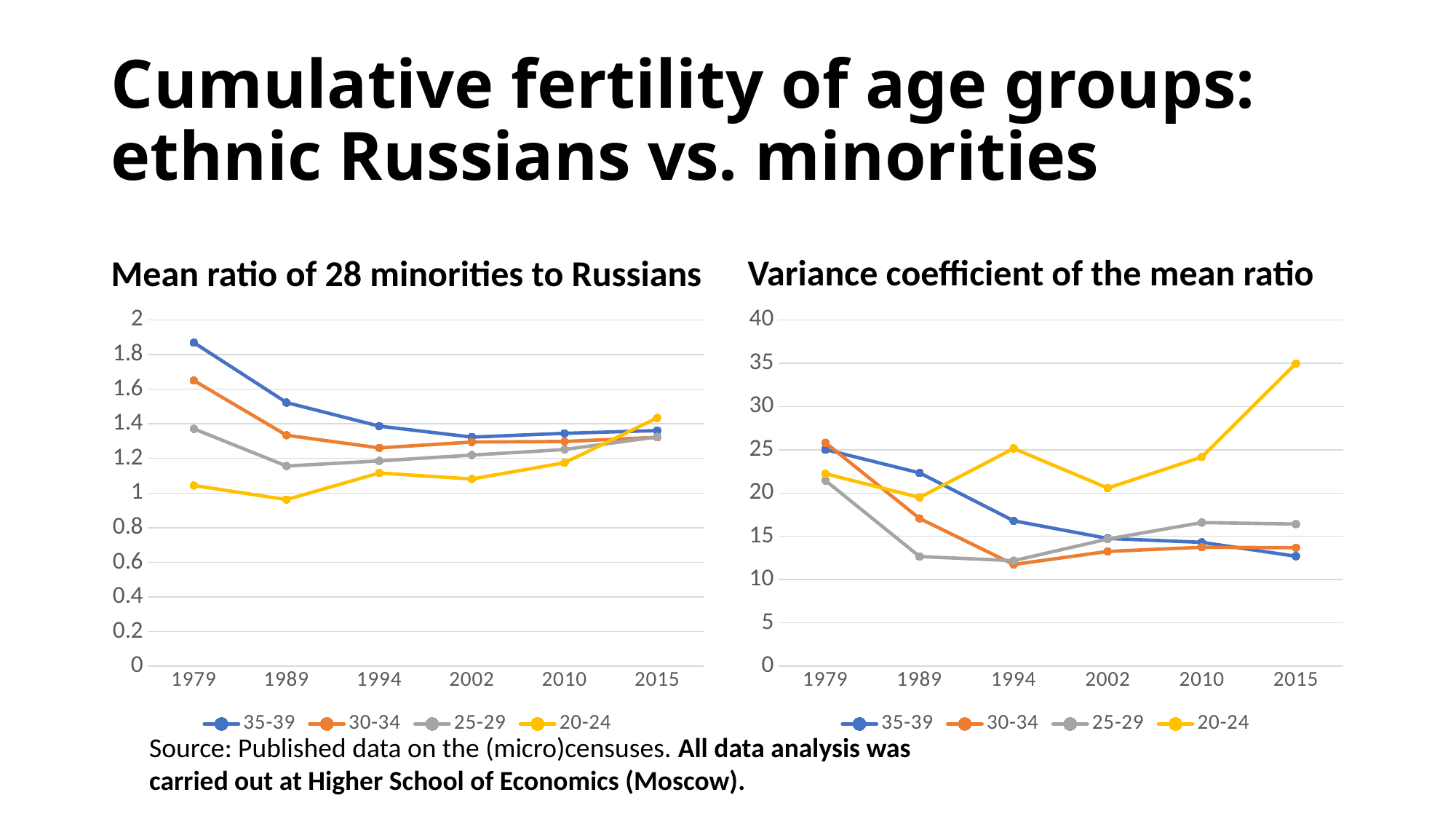
In the 'Variance coefficient of the mean ratio' chart, does the 20-24 line rise or fall from 2010 to 2015? rise In the 'Variance coefficient of the mean ratio' chart, is the value for 30-34 in 1994 greater or less than 15? less In the 'Mean ratio of 28 minorities to Russians' chart, which age group has the lowest value in 1979? 20-24 In the 'Mean ratio of 28 minorities to Russians' chart, does the 35-39 line rise or fall from 1979 to 2002? fall How many years are shown on the x axis of the 'Mean ratio of 28 minorities to Russians' chart? 6 In the 'Variance coefficient of the mean ratio' chart, which age group has the highest value in 2015? 20-24 In the 'Mean ratio of 28 minorities to Russians' chart, is the value for 35-39 in 1979 greater or less than 1.8? greater How many series does the legend of the 'Variance coefficient of the mean ratio' chart list? 4 In the 'Mean ratio of 28 minorities to Russians' chart, is the value for 20-24 in 1979 greater or less than 1.2? less What kind of chart is the 'Mean ratio of 28 minorities to Russians' chart? line chart In the 'Mean ratio of 28 minorities to Russians' chart, which age group has the highest value in 1979? 35-39